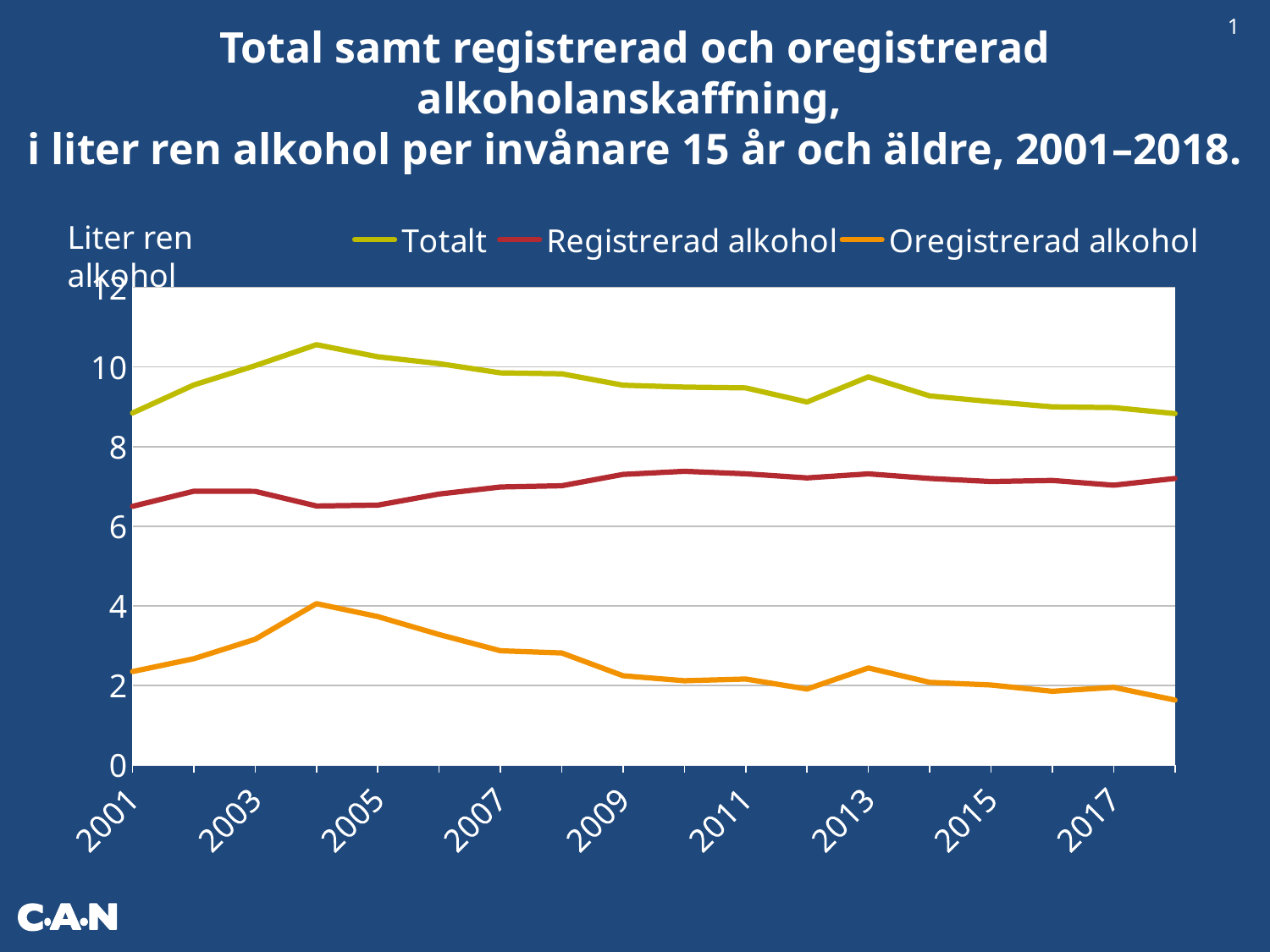
How many series does the legend list? 3 Is the value for Totalt in 2001 greater or less than 10? less Does the Oregistrerad alkohol series rise or fall from 2004 to 2018? fall Is the value for Totalt in 2004 greater or less than 10? greater Is the value for Registrerad alkohol in 2001 greater or less than 6? greater What is the label on the y axis? Liter ren alkohol In which year does the Totalt series reach its highest value? 2004 What kind of chart is shown on the slide? line chart In which year does the Oregistrerad alkohol series reach its highest value? 2004 In 2010, which is larger: Registrerad alkohol or Oregistrerad alkohol? Registrerad alkohol Which series is shown in orange? Oregistrerad alkohol